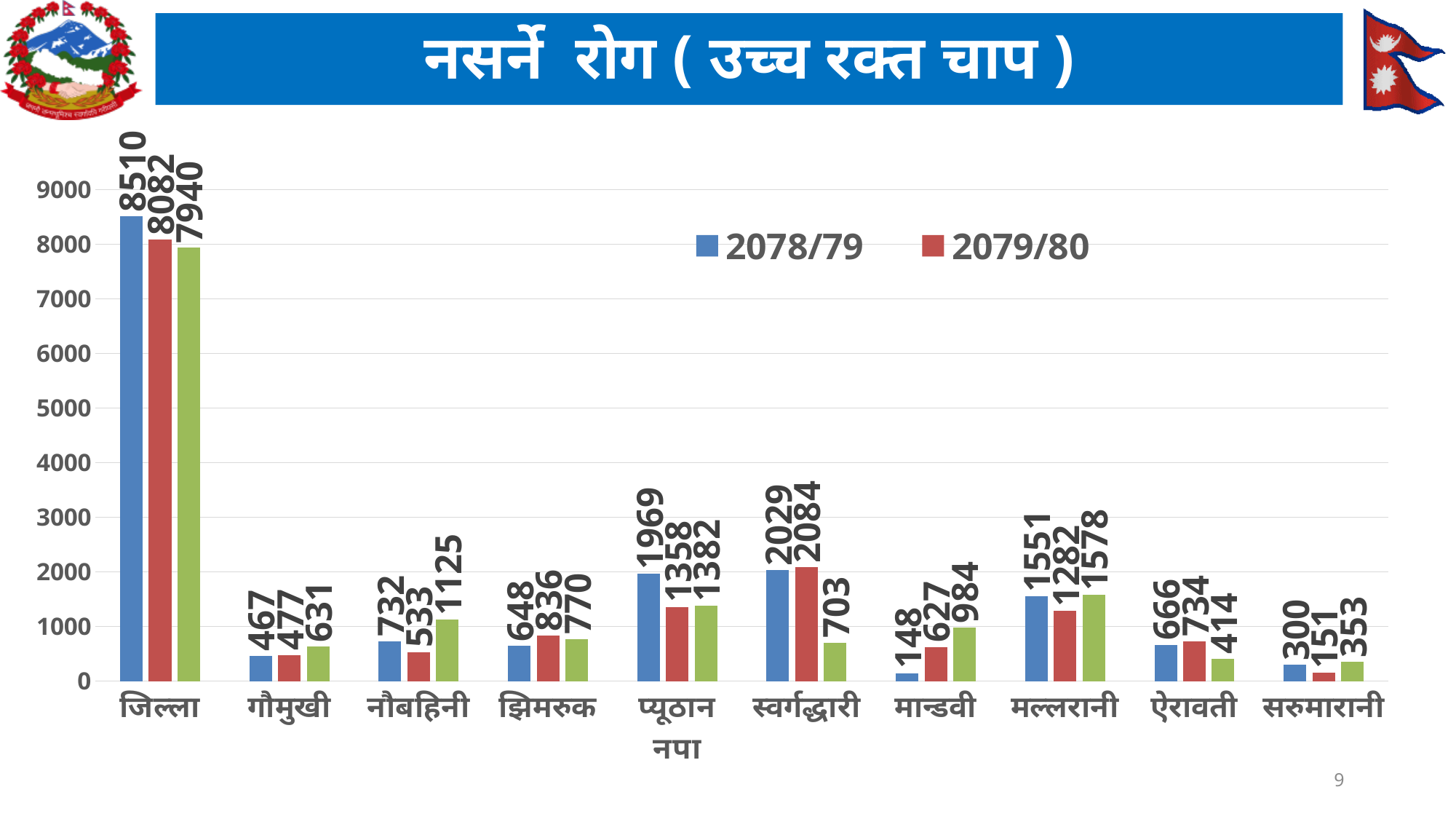
What is the value for सरुमारानी in the 2079/80 series? 151 What is the difference between the 2078/79 and 2079/80 values for प्यूठान नपा? 611 Is the 2079/80 value for झिमरुक greater or less than 1000? less Which category has the lowest value in the 2079/80 series? सरुमारानी How many series does the legend list? 2 Which category has the highest value in the 2078/79 series? जिल्ला What is the value for माण्डवी in the 2078/79 series? 148 How many categories are shown on the x axis? 10 What is the value for जिल्ला in the 2078/79 series? 8510 Which is larger for मल्लरानी: the 2078/79 value or the 2079/80 value? 2078/79 What is the value for स्वर्गद्वारी in the 2079/80 series? 2084 What kind of chart is shown on the slide? bar chart